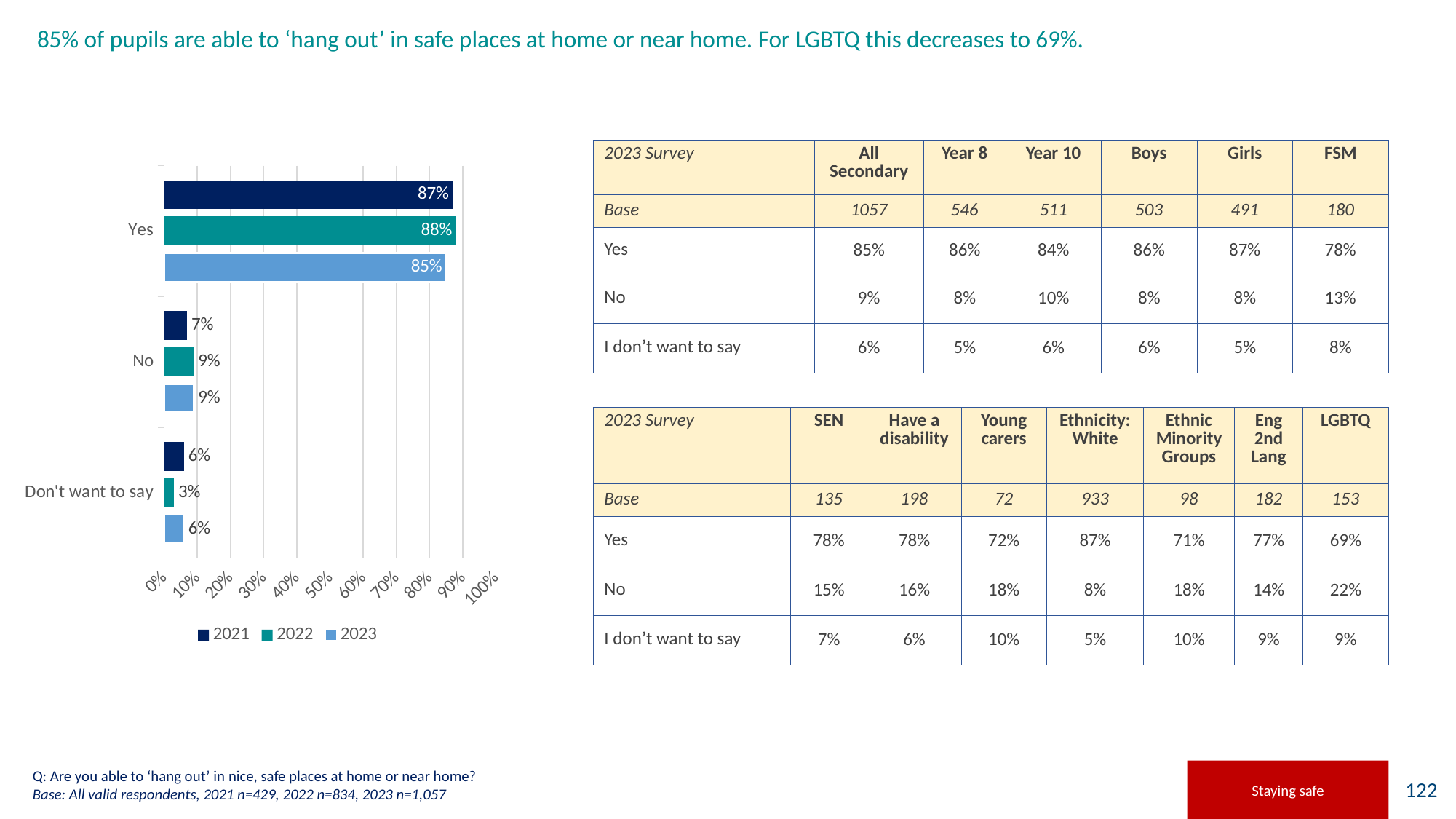
What is the 2023 value for 'Yes' in the chart? 85% Which year has the highest value for 'Yes' in the chart? 2022 What is the 2022 value for 'Don't want to say' in the chart? 3% What is the 2021 value for 'No' in the chart? 7% What is the difference between the 2022 and 2023 values for 'Yes' in the chart? 3% Which year has the lowest value for 'Don't want to say' in the chart? 2022 What kind of chart is shown on the slide? bar chart Which years are listed in the chart legend? 2021, 2022, 2023 Is the 2021 value for 'Yes' larger or smaller than the 2023 value for 'Yes'? larger How many series does the chart legend list? 3 How many response categories are shown on the chart? 3 Is the 2023 value for 'Yes' greater or less than 80%? greater